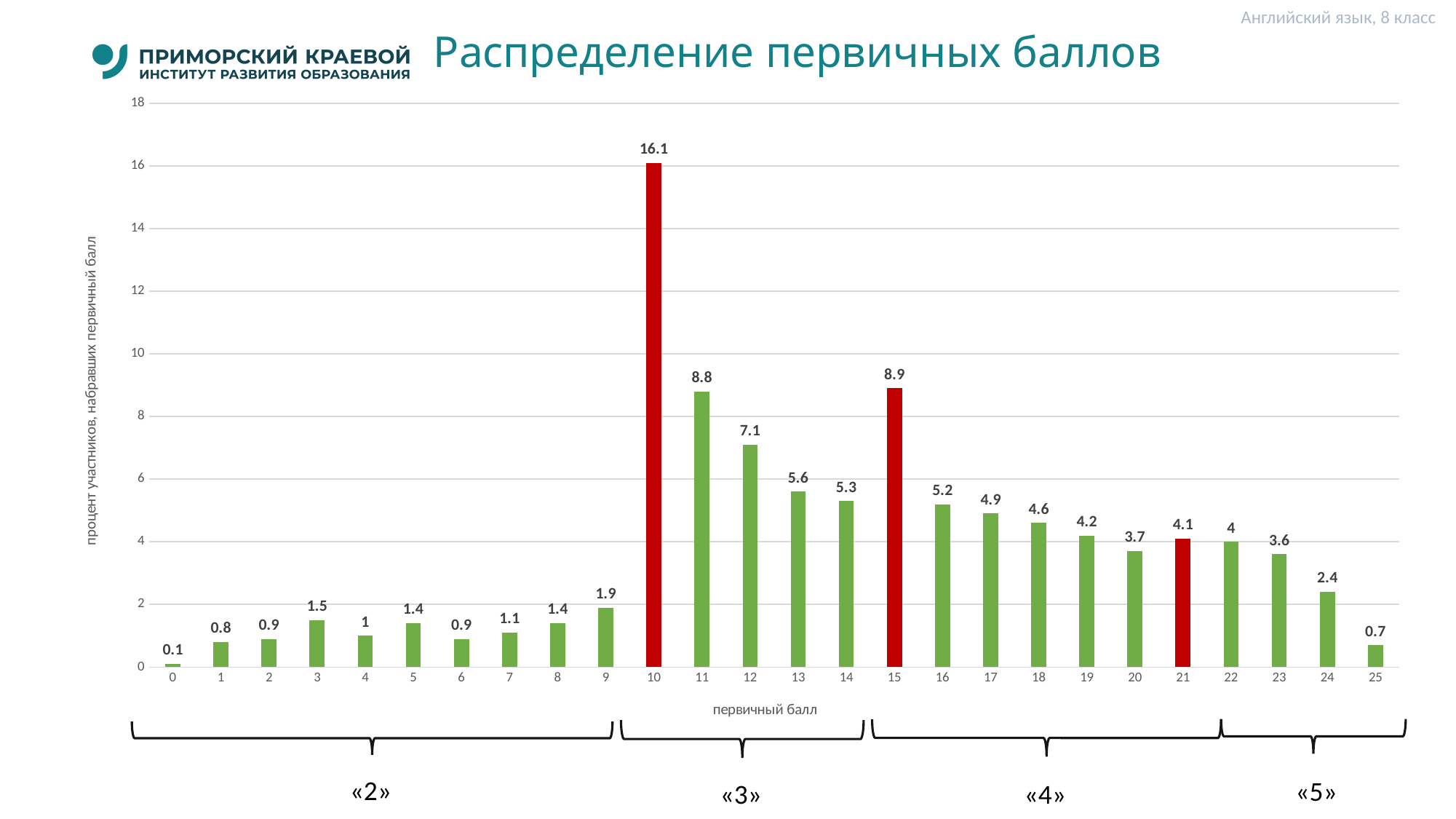
What is the value for primary score 15? 8.9 Which primary score has the highest value? 10 Do the values rise or fall from primary score 15 to primary score 20? fall What is the value for primary score 10? 16.1 What kind of chart is shown on the slide? bar chart Which primary score has the lowest value? 0 Which has a larger value, primary score 12 or primary score 13? 12 What is the difference between the values for primary scores 10 and 11? 7.3 How many bars are coloured red? 3 How many primary score categories are shown on the x axis? 26 Is the value for primary score 14 greater or less than 4? greater What is the value for primary score 25? 0.7